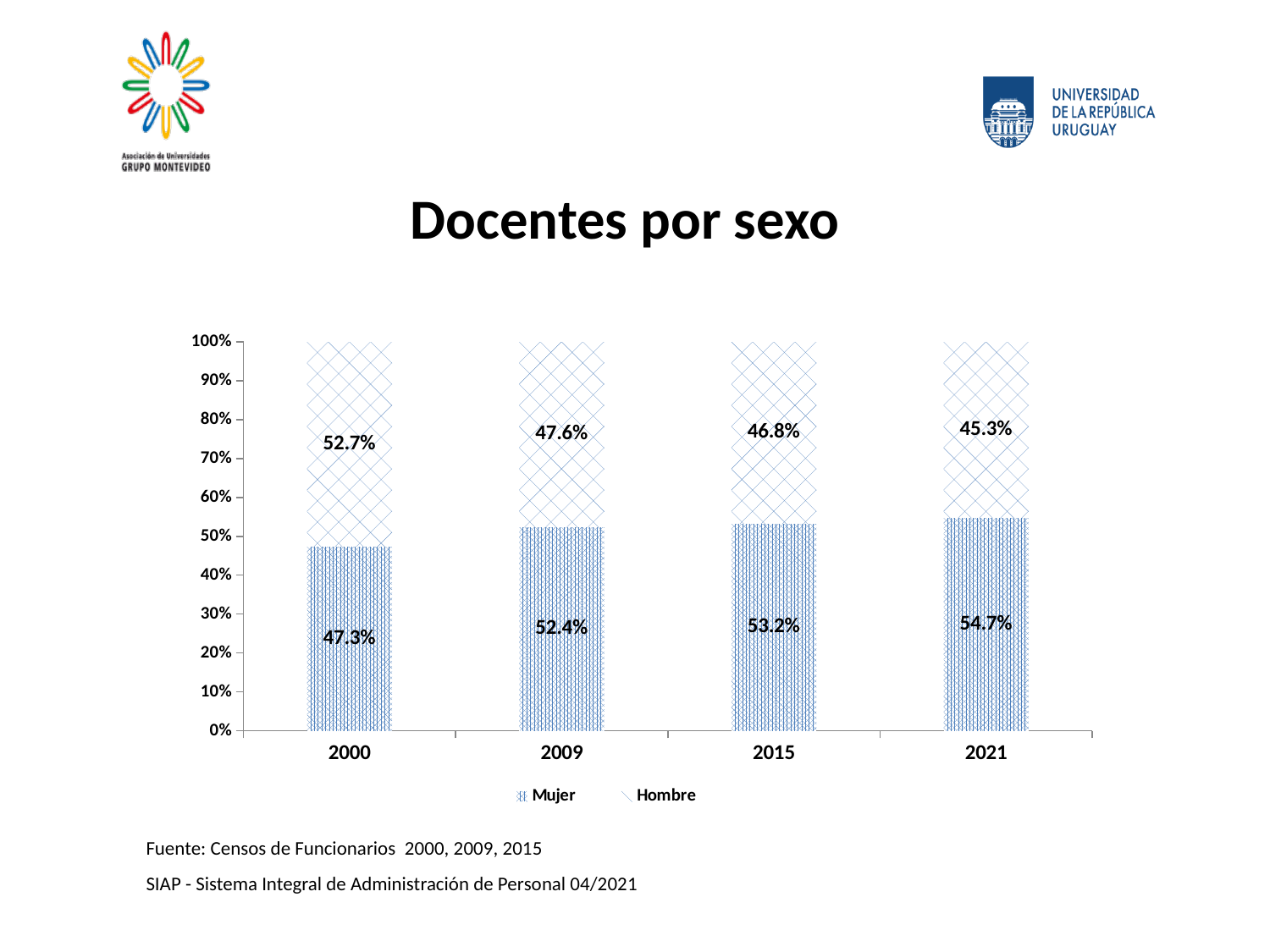
Does the Mujer share rise or fall from 2000 to 2021? Rise In which year is the Hombre share lowest? 2021 What is the value for Hombre in 2015? 46.8% In which year is the Mujer share highest? 2021 How many series does the legend list? 2 What kind of chart is shown? Stacked bar chart What is the value for Mujer in 2009? 52.4% What is the value for Mujer in 2021? 54.7% What is the value for Hombre in 2000? 52.7% Which is larger in 2000, the Mujer share or the Hombre share? Hombre What is the difference between the Mujer and Hombre shares in 2021? 9.4% How many years are shown on the x axis? 4